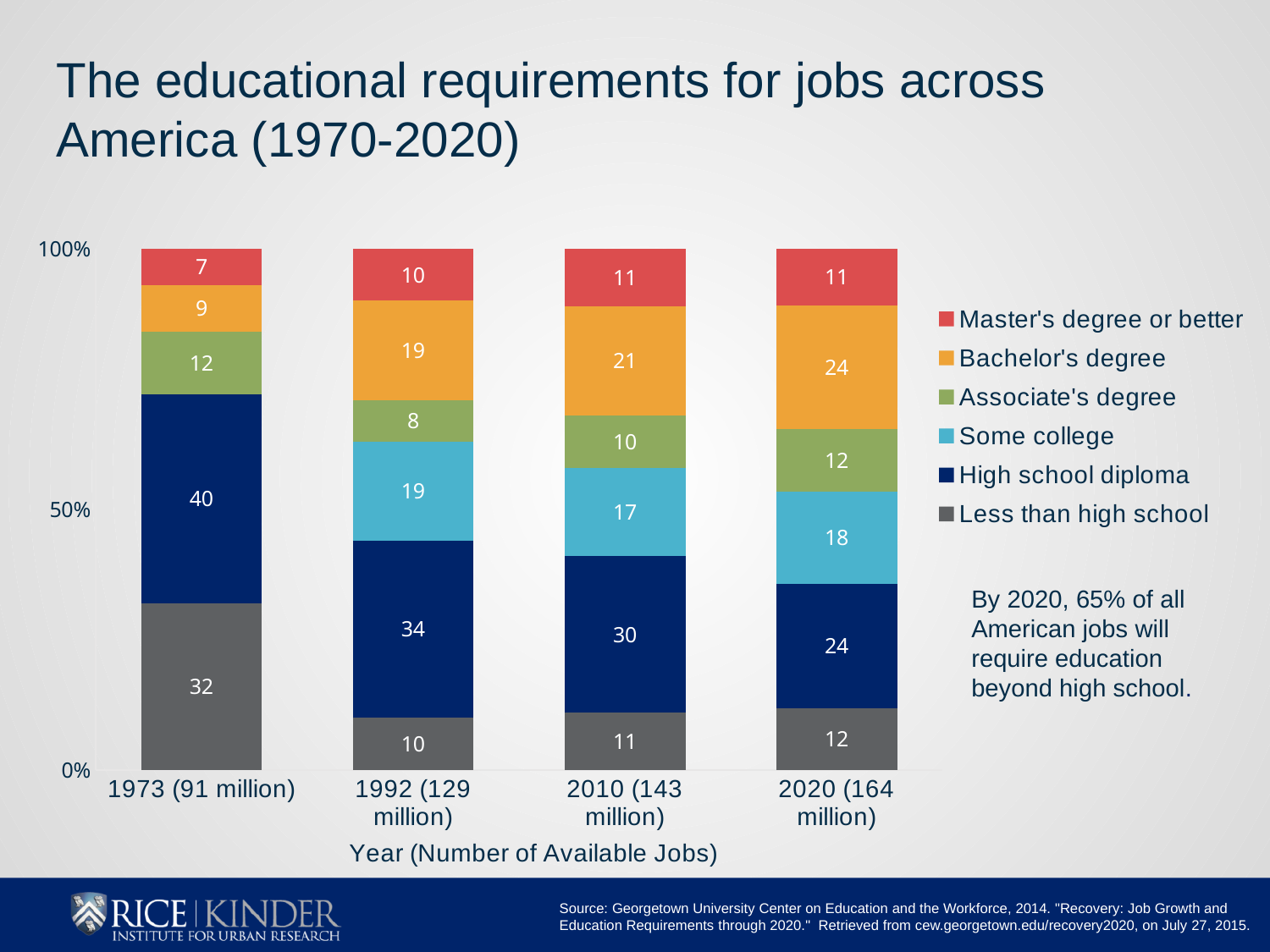
What is the value for Some college in 1992 (129 million)? 19 Does the Bachelor's degree value rise or fall from 1973 to 2020? Rise In which year is the Less than high school value highest? 1973 (91 million) What is the value for Bachelor's degree in 2020 (164 million)? 24 Which is larger: the Bachelor's degree value in 1992 (129 million) or in 2010 (143 million)? 2010 (143 million) How many series does the legend list? 6 How many year categories are shown on the x axis? 4 What is the value for Less than high school in 2010 (143 million)? 11 What is the difference between the High school diploma values for 1973 (91 million) and 2020 (164 million)? 16 What kind of chart is shown on the slide? Stacked bar chart In which year is the Master's degree or better value lowest? 1973 (91 million) What is the value for High school diploma in 1973 (91 million)? 40